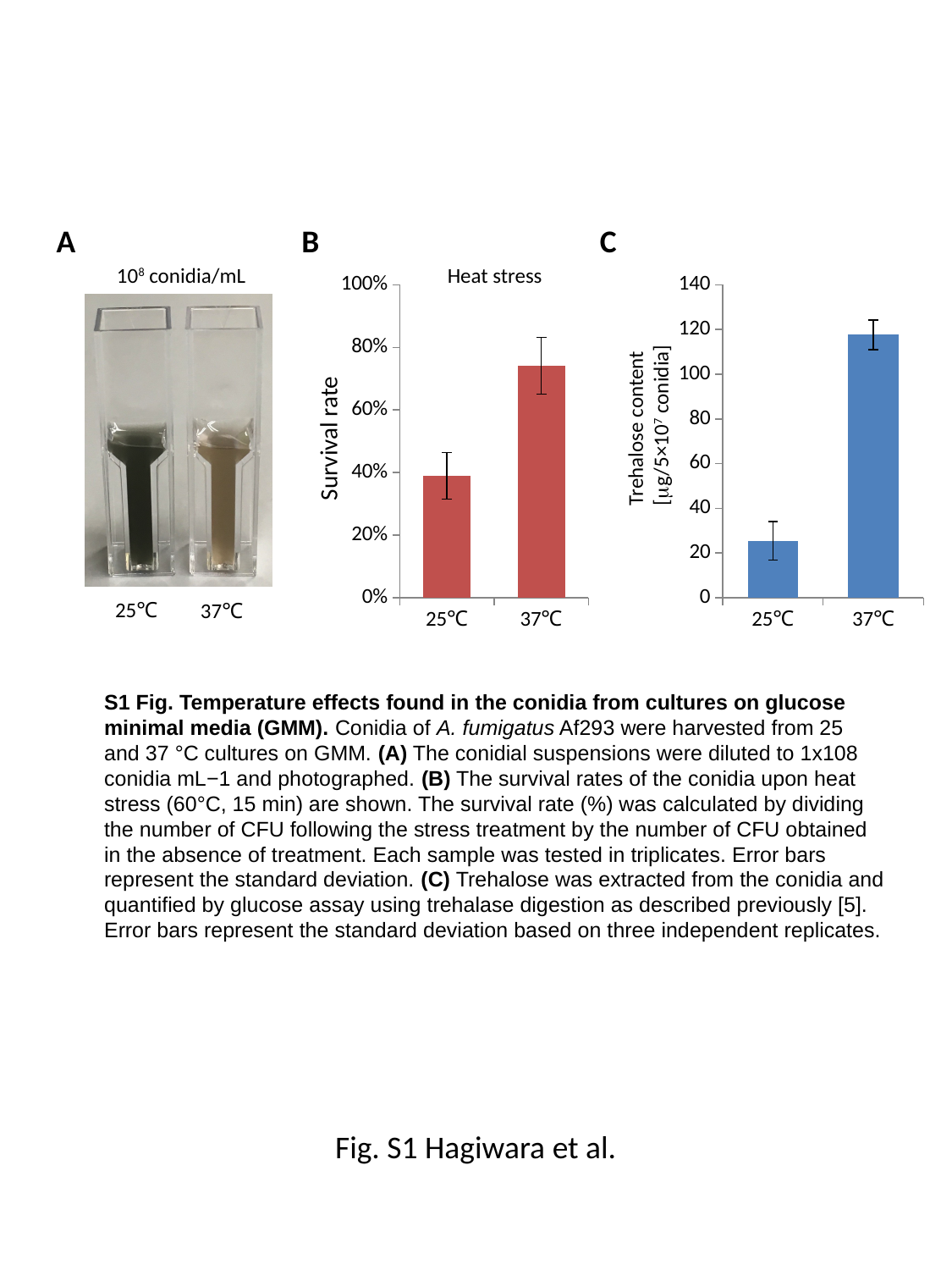
In the chart titled "Heat stress" (panel B), is the survival rate for 37°C greater or less than 60%? greater What is the y-axis label of the chart in panel B? Survival rate In the chart titled "Heat stress" (panel B), how many temperature categories are plotted? 2 In the trehalose content chart (panel C), is the value for 25°C larger or smaller than the value for 37°C? smaller In the chart titled "Heat stress" (panel B), which temperature has the higher survival rate? 37°C In the chart titled "Heat stress" (panel B), which temperature has the lower survival rate? 25°C In the trehalose content chart (panel C), which temperature has the higher trehalose content? 37°C In the trehalose content chart (panel C), is the value for 25°C greater or less than 40? less In the chart titled "Heat stress" (panel B), is the survival rate for 25°C greater or less than 20%? greater What is the title of the chart in panel B? Heat stress What kind of chart is the "Heat stress" chart in panel B? bar chart